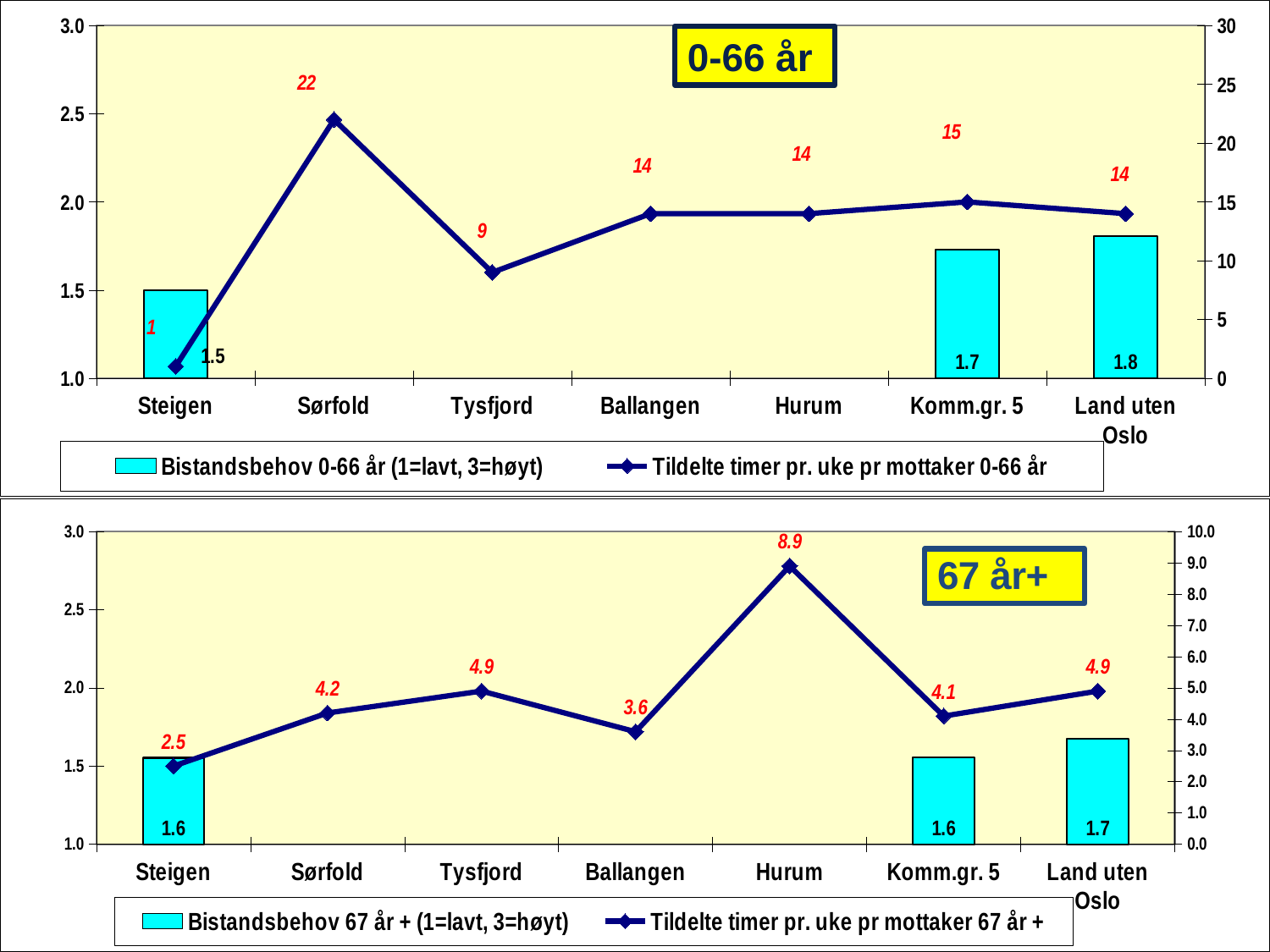
In the "67 år+" chart, which category has the highest Tildelte timer pr. uke pr mottaker value? Hurum In the "0-66 år" chart, what is the difference between the Tildelte timer values for Sørfold and Tysfjord? 13 How many categories are shown on the x axis of the "67 år+" chart? 7 In the "0-66 år" chart, which category has the lowest Tildelte timer pr. uke pr mottaker value? Steigen In the "67 år+" chart, what is the Bistandsbehov value for Komm.gr. 5? 1.6 In the "0-66 år" chart, which category has the highest Tildelte timer pr. uke pr mottaker value? Sørfold How many series does the legend of the "0-66 år" chart list? 2 In the "67 år+" chart, which is larger, the Tildelte timer value for Sørfold or for Ballangen? Sørfold In the "0-66 år" chart, what is the Bistandsbehov value for Land uten Oslo? 1.8 In the "0-66 år" chart, what is the value of Tildelte timer pr. uke pr mottaker for Sørfold? 22 In the "67 år+" chart, what is the Tildelte timer pr. uke pr mottaker value for Hurum? 8.9 In the "67 år+" chart, which category has the lowest Tildelte timer pr. uke pr mottaker value? Steigen